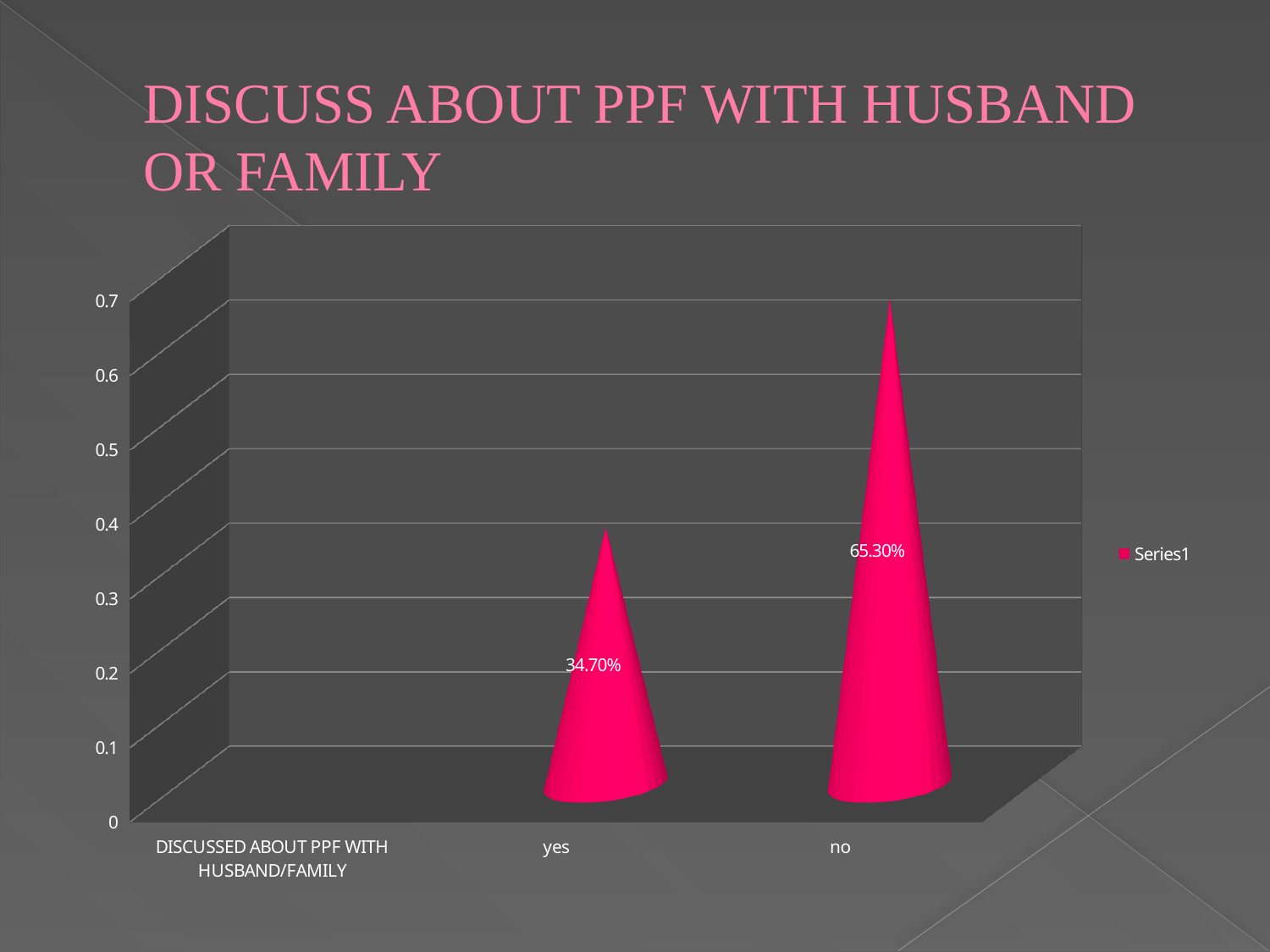
What kind of chart is shown on the slide? bar chart Is the value for "yes" greater or less than 0.4 on the axis? less What is the name of the series shown in the legend? Series1 Is the value for "no" greater or less than 0.5 on the axis? greater What is the value for "yes"? 34.70% Which category has the highest value? no How many series does the legend list? 1 How many bars are plotted on the chart? 2 Which is larger, the value for "yes" or the value for "no"? no Which category has the lowest plotted value? yes What is the value for "no"? 65.30% What is the difference between the values for "no" and "yes"? 30.60%